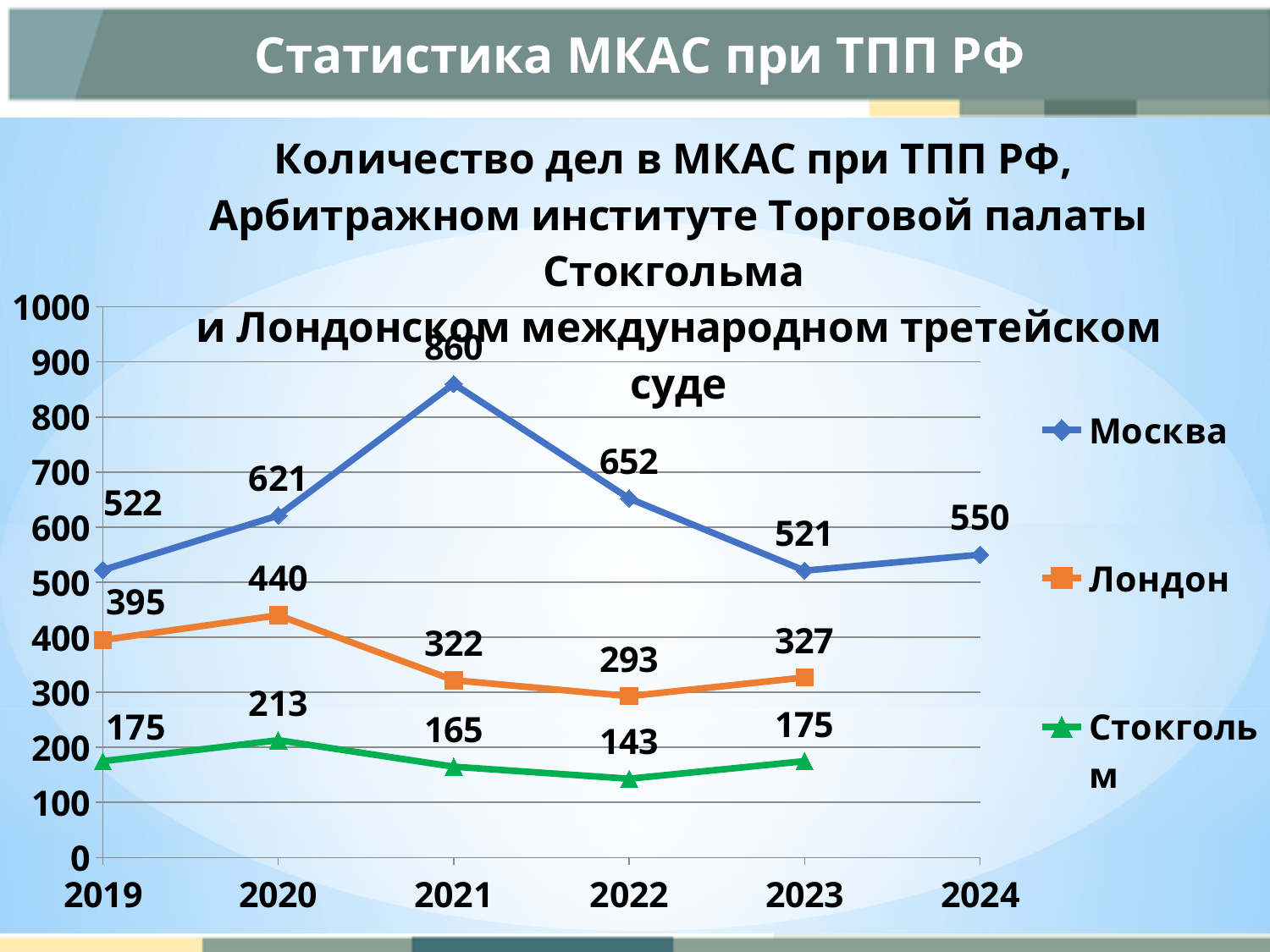
In which year does the Стокгольм series have its lowest value? 2022 Is the value for Москва in 2024 greater or less than 500? greater Which is larger: the Лондон value in 2019 or the Лондон value in 2023? 2019 What is the value for Москва in 2021? 860 How many years are shown on the x axis? 6 What is the difference between the Москва values in 2021 and 2022? 208 How many series does the legend list? 3 What is the value for Стокгольм in 2020? 213 In which year does the Москва series reach its highest value? 2021 What type of chart is shown on the slide? line chart What is the value for Лондон in 2022? 293 Does the Лондон series rise or fall from 2020 to 2022? fall